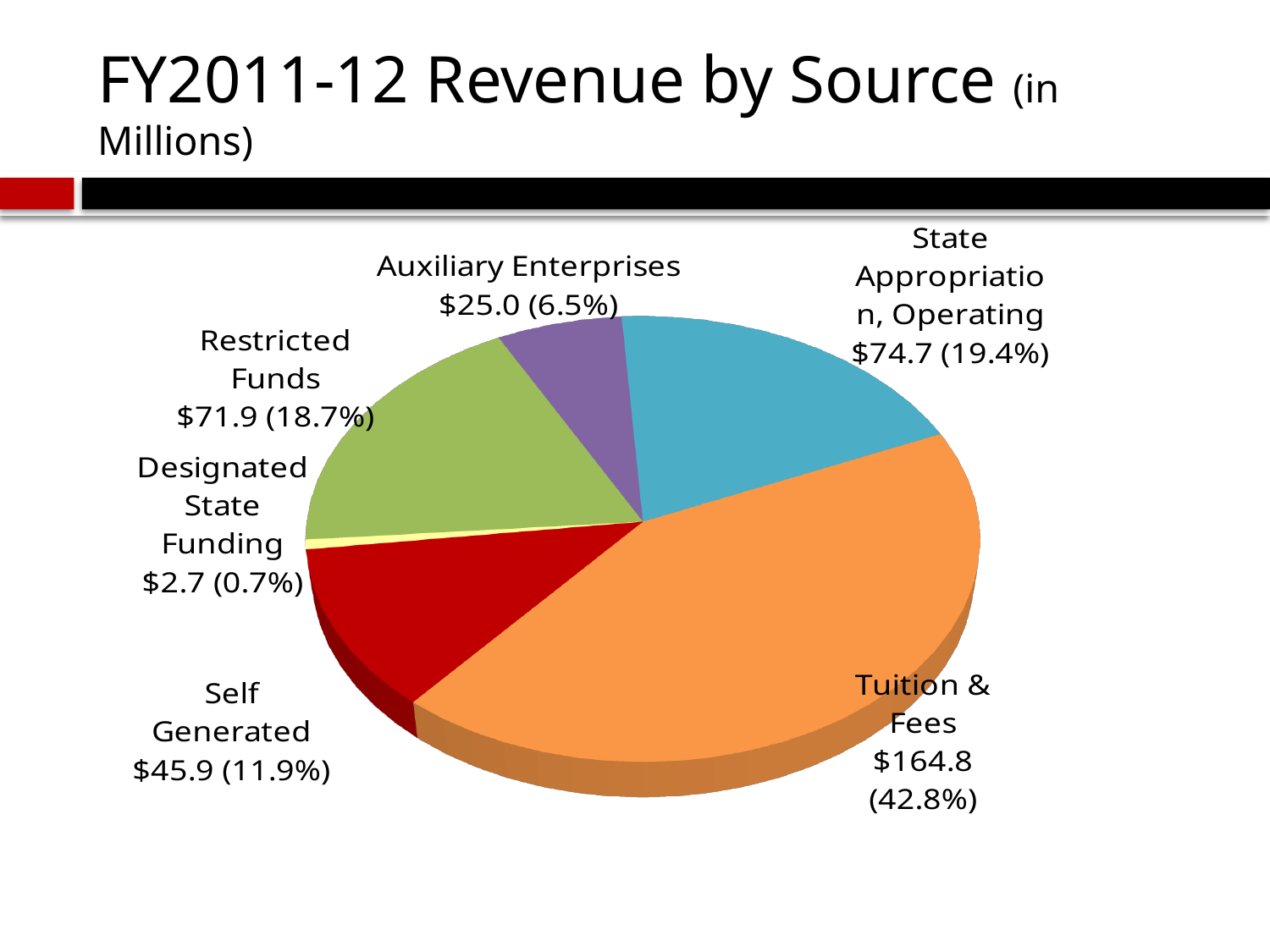
What share of the pie does Self Generated revenue represent? 11.9% What is the revenue from Restricted Funds? $71.9 What is the revenue from Tuition & Fees? $164.8 What is the difference between Tuition & Fees and State Appropriation, Operating revenue? $90.1 What is the revenue from Designated State Funding? $2.7 Which revenue source is the smallest? Designated State Funding Which revenue source is the largest? Tuition & Fees Which is larger, State Appropriation, Operating or Restricted Funds? State Appropriation, Operating What is the title of the slide? FY2011-12 Revenue by Source (in Millions) How many revenue sources are shown in the pie chart? 6 What share of the pie does Auxiliary Enterprises represent? 6.5% What type of chart is shown on the slide? Pie chart